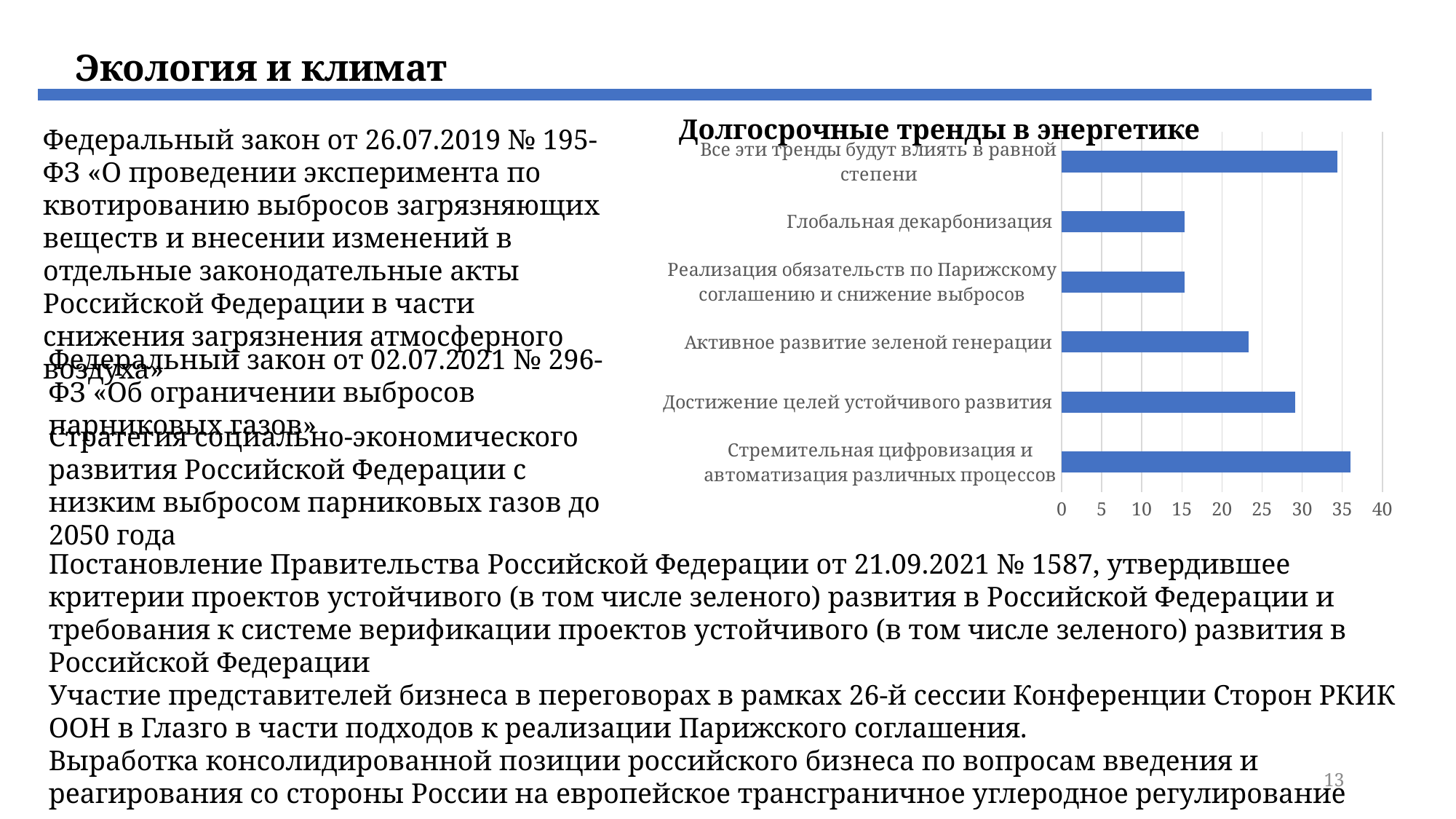
Is the value for "Активное развитие зеленой генерации" greater or less than 20? greater What is the title of the chart on the slide? Долгосрочные тренды в энергетике Which is larger: the value for "Активное развитие зеленой генерации" or for "Глобальная декарбонизация"? Активное развитие зеленой генерации What is the highest value shown on the chart's horizontal axis? 40 Which is larger: the value for "Достижение целей устойчивого развития" or for "Активное развитие зеленой генерации"? Достижение целей устойчивого развития Is the value for "Активное развитие зеленой генерации" greater or less than 25? less Is the value for "Все эти тренды будут влиять в равной степени" greater or less than 30? greater What kind of chart is shown on the slide? bar chart How many categories does the chart show? 6